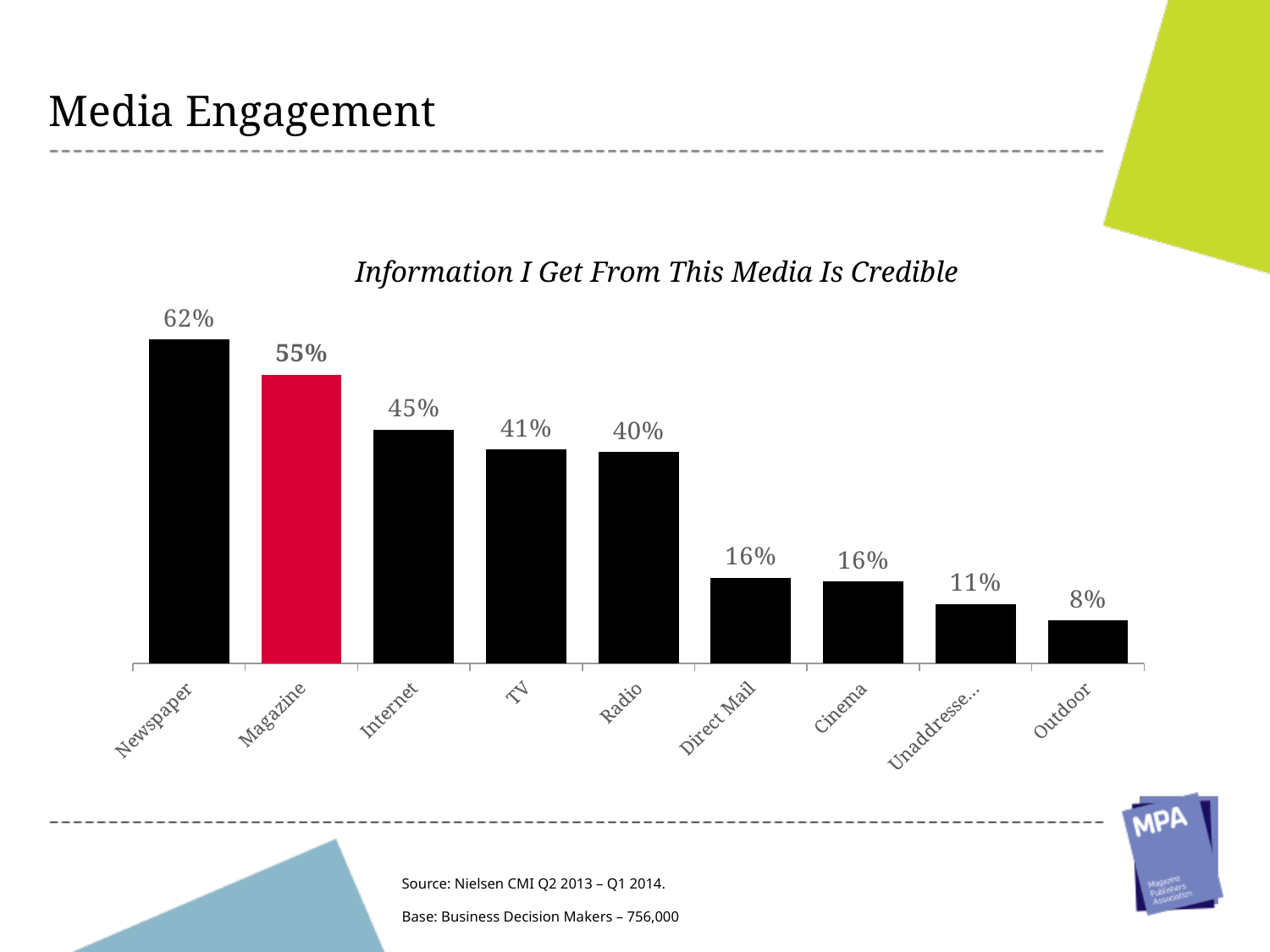
How many categories are shown in the chart? 9 What is the value for Radio? 40% Which category has the lowest value? Outdoor What is the title of the chart? Information I Get From This Media Is Credible Which is larger, the value for TV or the value for Cinema? TV What is the difference between the values for Internet and Direct Mail? 29% What is the value for Magazine? 55% What is the difference between the values for Newspaper and Magazine? 7% Which category has the highest value? Newspaper What kind of chart is shown on the slide? Bar chart What is the value for Outdoor? 8% What is the value for Newspaper? 62%